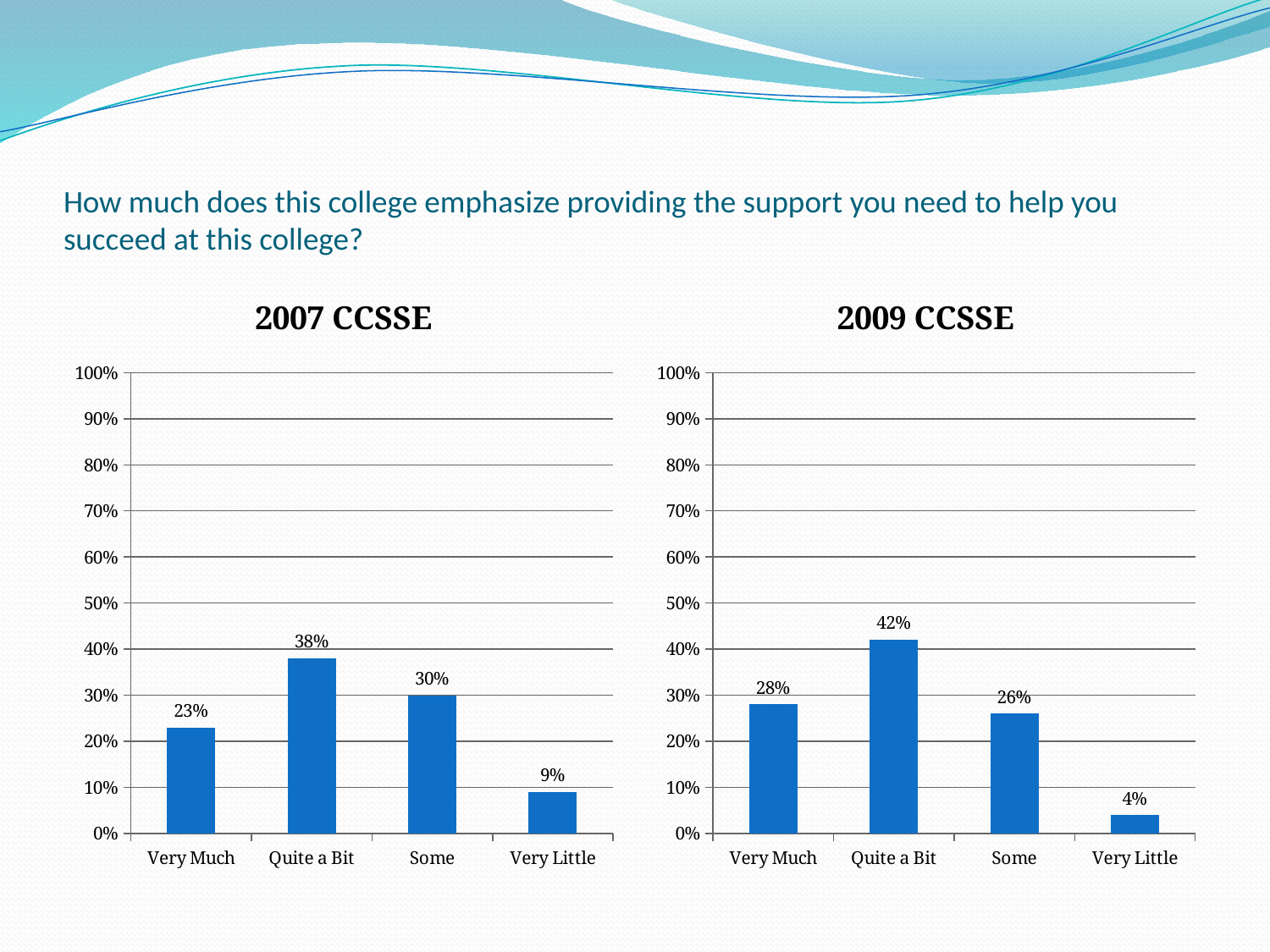
What is the title of the chart on the right side of the slide? 2009 CCSSE In the 2009 CCSSE chart, what is the value for Very Much? 28% How many categories are shown in the 2009 CCSSE chart? 4 In the 2007 CCSSE chart, which category has the highest value? Quite a Bit In the 2007 CCSSE chart, what is the value for Quite a Bit? 38% In the 2007 CCSSE chart, is the value for Very Little greater or less than 10%? less In the 2009 CCSSE chart, what is the difference between the values for Quite a Bit and Some? 16% In the 2007 CCSSE chart, what is the difference between the values for Some and Very Much? 7% Which is larger: the value for Very Much in the 2007 CCSSE chart or the value for Very Much in the 2009 CCSSE chart? 2009 CCSSE What kind of chart is the 2007 CCSSE chart? bar chart In the 2009 CCSSE chart, which category has the lowest value? Very Little In the 2009 CCSSE chart, what is the value for Very Little? 4%